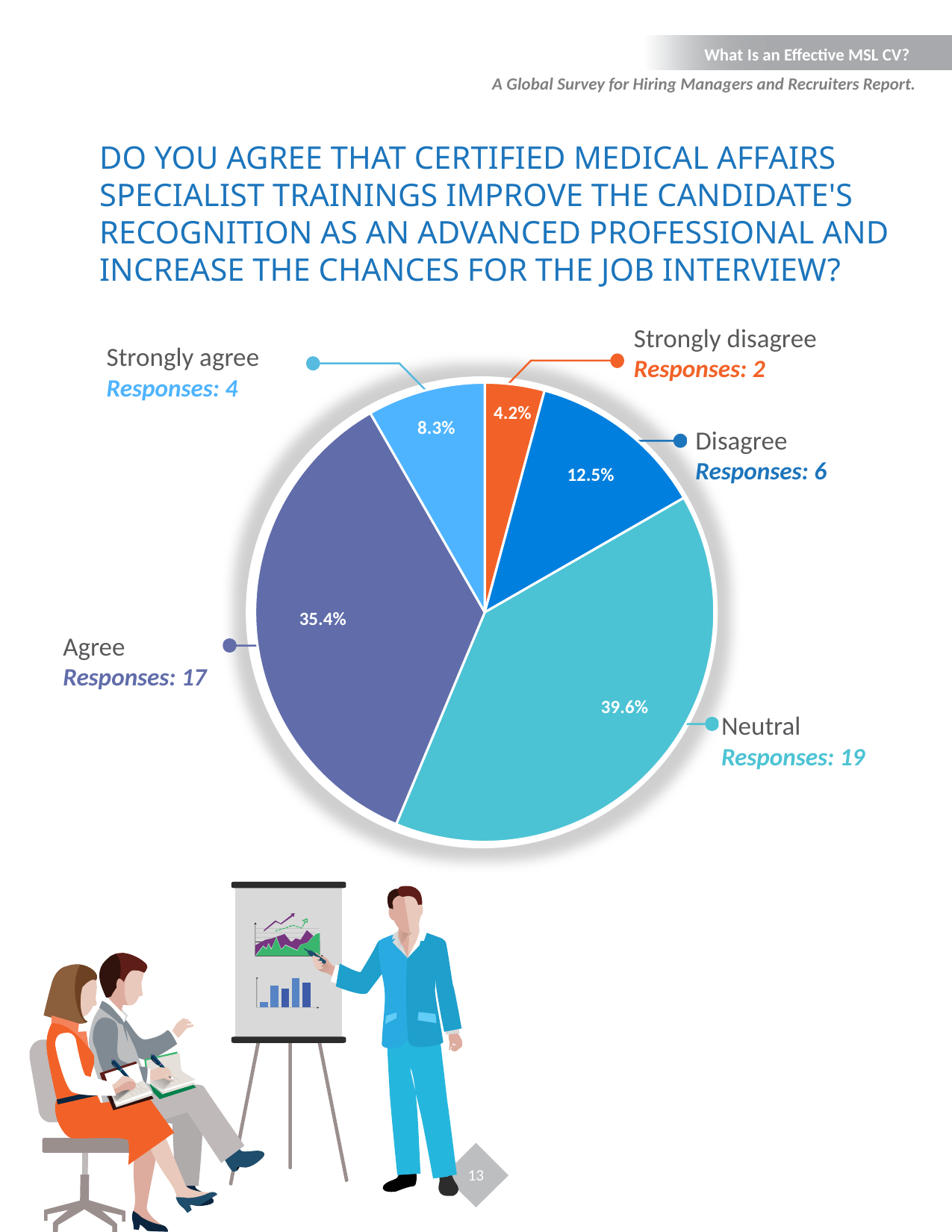
What percentage share does the Agree slice have? 35.4% How many categories does the pie chart have? 5 What colour is the Strongly disagree slice? orange What is the total number of responses across all categories? 48 How many responses were recorded for Disagree? 6 Which has more responses, Disagree or Strongly agree? Disagree Which category has the smallest share of the pie? Strongly disagree What is the difference in responses between Neutral and Agree? 2 What percentage share does the Neutral slice have? 39.6% How many responses were recorded for Strongly agree? 4 Which category has the largest share of the pie? Neutral What kind of chart is shown on the slide? pie chart